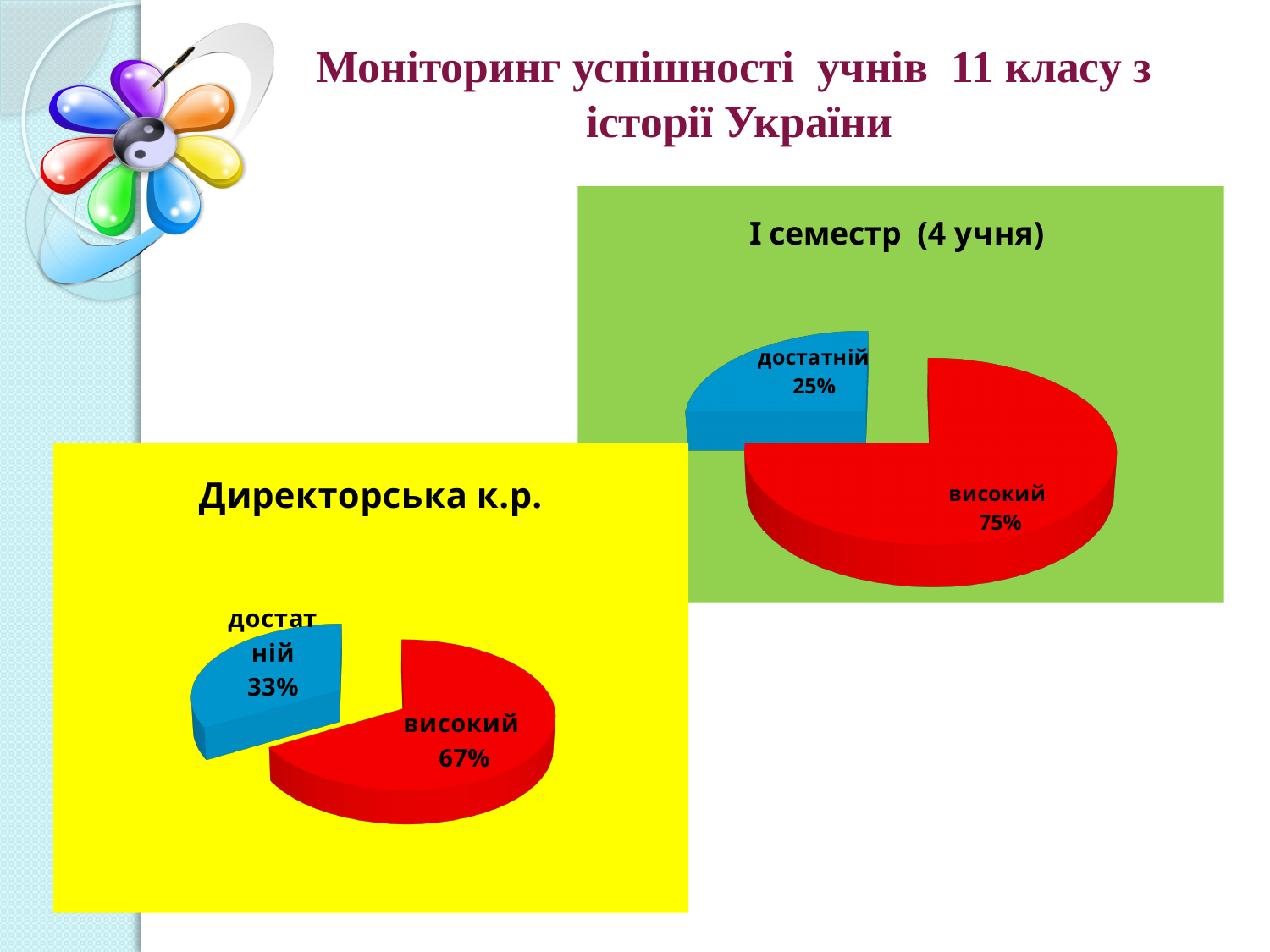
In the chart titled "І семестр (4 учня)", what colour is the "високий" slice? Red In the chart titled "Директорська к.р.", which category has the smallest slice? достатній In the chart titled "Директорська к.р.", which is larger, the "високий" slice or the "достатній" slice? високий In the chart titled "Директорська к.р.", what share does the "високий" slice have? 67% In the chart titled "І семестр (4 учня)", what share does the "достатній" slice have? 25% In the chart titled "Директорська к.р.", what is the difference between the "високий" and "достатній" shares? 34% How many slices does the chart titled "Директорська к.р." have? 2 What kind of chart is the chart titled "І семестр (4 учня)"? Pie chart In the chart titled "І семестр (4 учня)", what share does the "високий" slice have? 75% In the chart titled "І семестр (4 учня)", which category has the largest slice? високий In the chart titled "І семестр (4 учня)", what is the difference between the "високий" and "достатній" shares? 50%